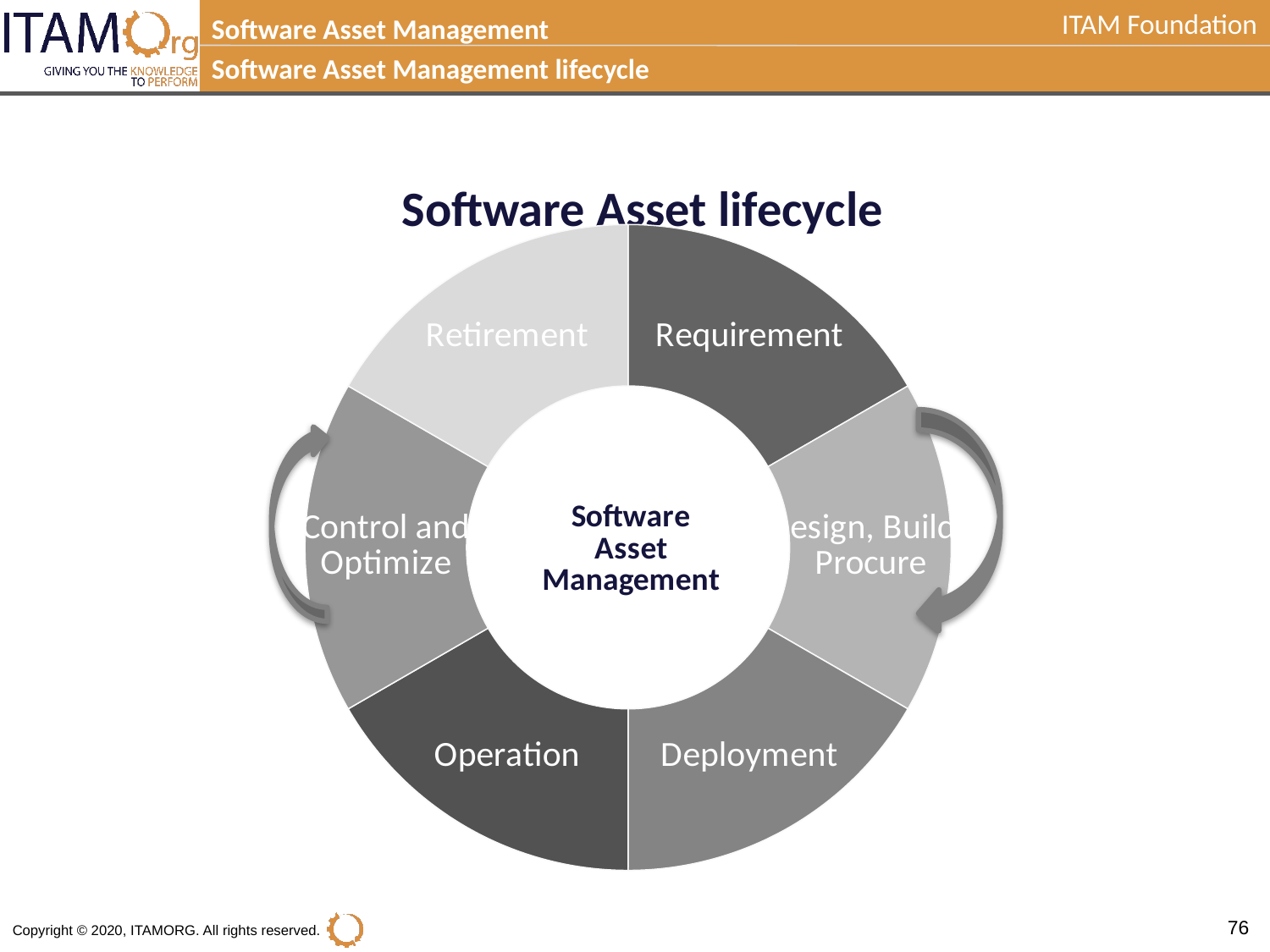
What text appears in the centre of the Software Asset lifecycle ring? Software Asset Management Which stage of the Software Asset lifecycle is shown at the bottom right of the ring? Deployment How many stages (segments) does the Software Asset lifecycle ring show? 6 Which stage of the Software Asset lifecycle is shown on the left side of the ring, between Operation and Retirement? Control and Optimize Which stage of the Software Asset lifecycle is shown directly below Requirement, on the right side of the ring? Design, Build, Procure What is the title of the diagram on the slide? Software Asset lifecycle Which stage of the Software Asset lifecycle is shown at the top left of the ring? Retirement Which stage of the Software Asset lifecycle is shown at the bottom left of the ring? Operation